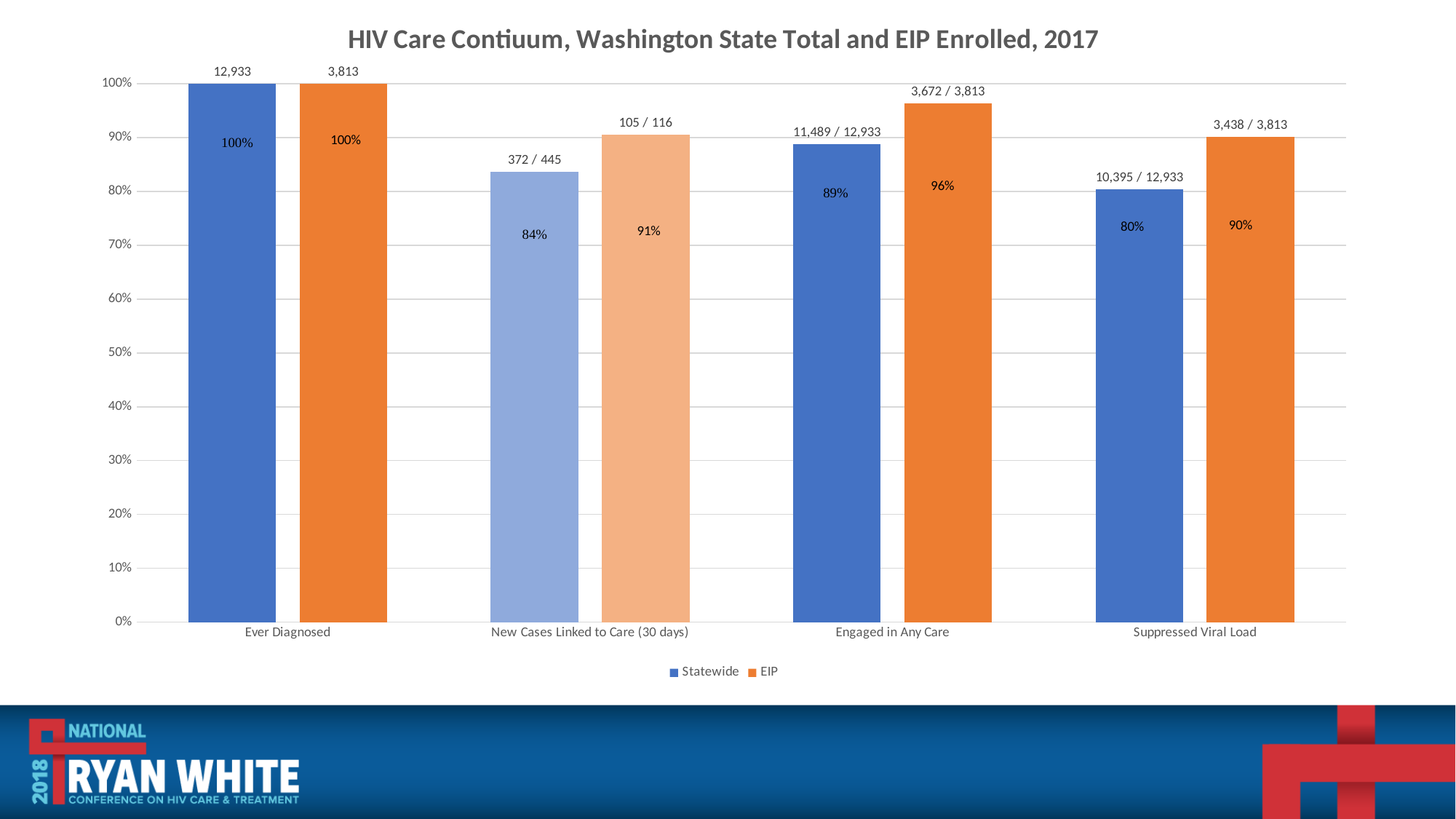
What is the difference in percentage points between the EIP and Statewide bars for Suppressed Viral Load? 10 How many series does the legend list? 2 What count label is shown above the EIP bar for Suppressed Viral Load? 3,438 / 3,813 Which series is shown in orange in the legend? EIP What is the Statewide percentage for Suppressed Viral Load? 80% What is the Statewide percentage for New Cases Linked to Care (30 days)? 84% Which is larger for Engaged in Any Care, the Statewide or the EIP percentage? EIP How many categories are shown on the x axis? 4 What is the EIP percentage for Engaged in Any Care? 96% Which category has the lowest Statewide percentage? Suppressed Viral Load What is the title of the chart? HIV Care Contiuum, Washington State Total and EIP Enrolled, 2017 What kind of chart is shown on the slide? Bar chart